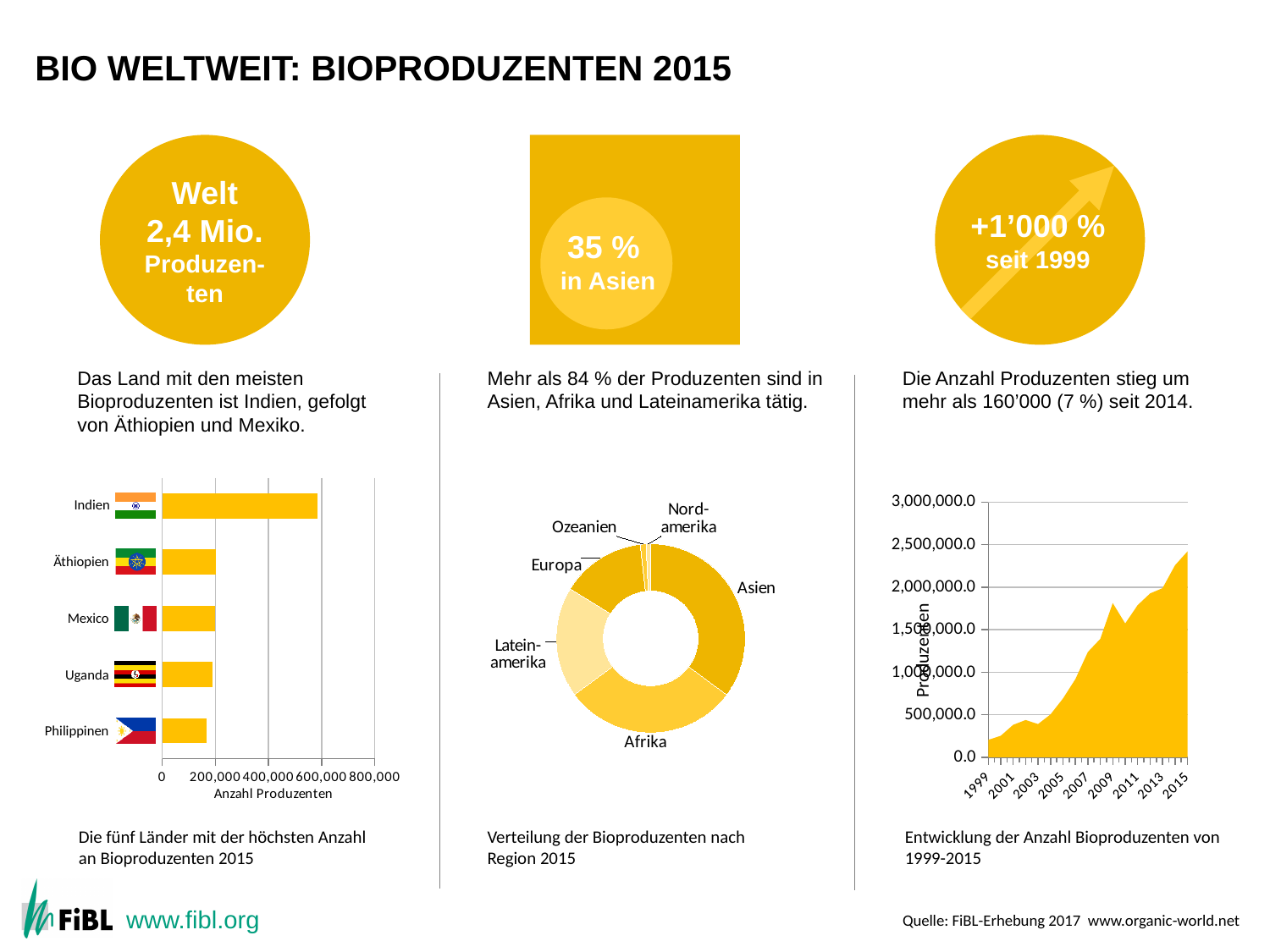
In the chart 'Die fünf Länder mit der höchsten Anzahl an Bioproduzenten 2015', is the value for Indien greater or less than 400,000? greater What is the x-axis title of the chart 'Die fünf Länder mit der höchsten Anzahl an Bioproduzenten 2015'? Anzahl Produzenten In the chart 'Verteilung der Bioproduzenten nach Region 2015', which is larger, the share for Afrika or the share for Europa? Afrika In the chart 'Die fünf Länder mit der höchsten Anzahl an Bioproduzenten 2015', is the value for Philippinen greater or less than 200,000? less In the chart 'Entwicklung der Anzahl Bioproduzenten von 1999-2015', is the value for 2015 greater or less than 2,000,000? greater In the chart 'Verteilung der Bioproduzenten nach Region 2015', which region has the largest share? Asien In the chart 'Die fünf Länder mit der höchsten Anzahl an Bioproduzenten 2015', which country has the lowest number of producers? Philippinen What kind of chart is 'Die fünf Länder mit der höchsten Anzahl an Bioproduzenten 2015'? bar chart In the chart 'Die fünf Länder mit der höchsten Anzahl an Bioproduzenten 2015', how many countries are shown? 5 In the chart 'Verteilung der Bioproduzenten nach Region 2015', how many regions are shown? 6 In the chart 'Die fünf Länder mit der höchsten Anzahl an Bioproduzenten 2015', which country has the highest number of producers? Indien In the chart 'Entwicklung der Anzahl Bioproduzenten von 1999-2015', do the values generally rise or fall from 1999 to 2015? rise